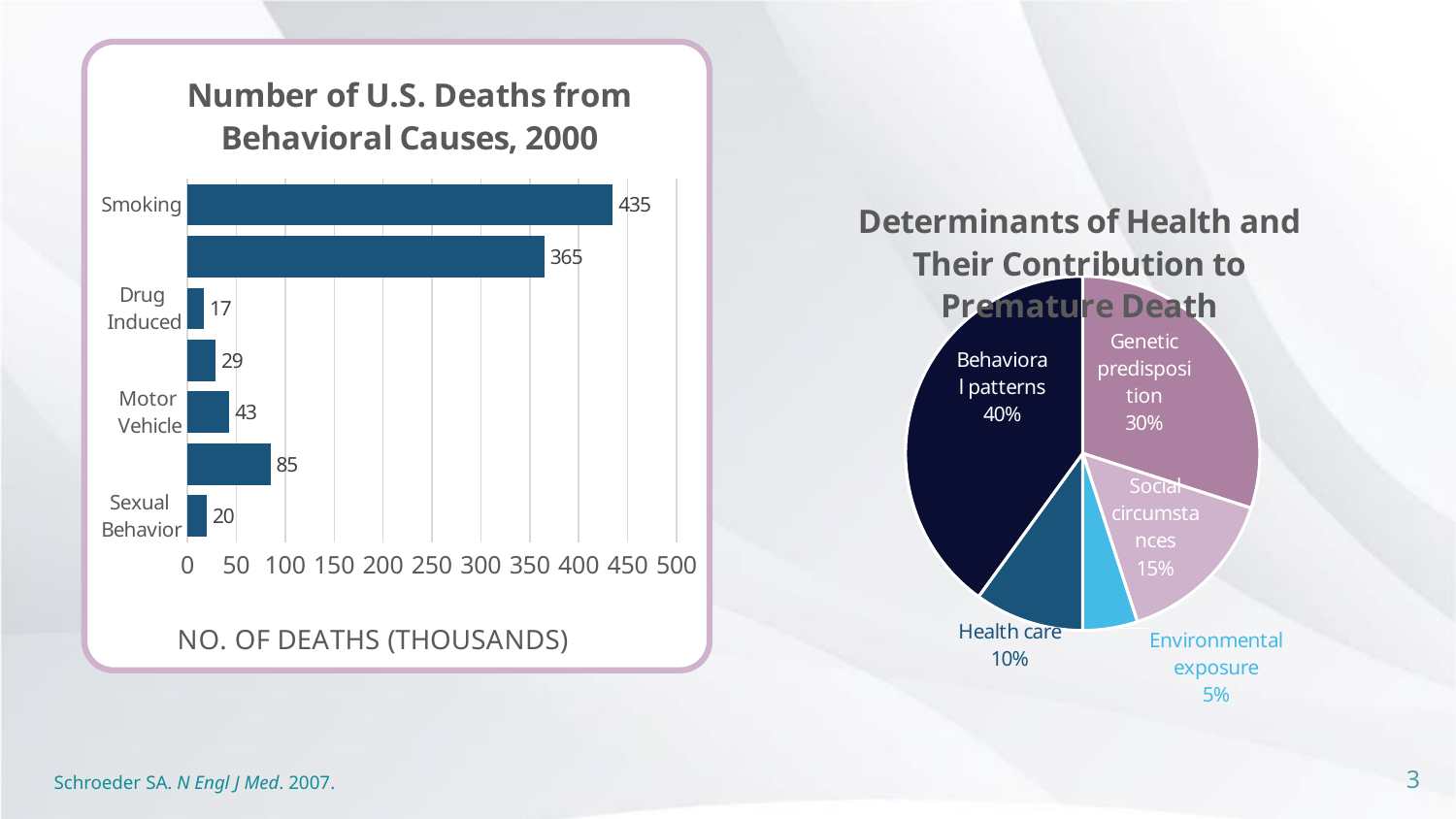
In the bar chart 'Number of U.S. Deaths from Behavioral Causes, 2000', what is the difference between the values for Smoking and Drug Induced? 418 In the bar chart 'Number of U.S. Deaths from Behavioral Causes, 2000', how many bars are plotted? 7 In the pie chart 'Determinants of Health and Their Contribution to Premature Death', how many slices are there? 5 What is the x-axis title of the bar chart on the left? NO. OF DEATHS (THOUSANDS) In the bar chart 'Number of U.S. Deaths from Behavioral Causes, 2000', which is larger, Motor Vehicle or Sexual Behavior? Motor Vehicle In the pie chart 'Determinants of Health and Their Contribution to Premature Death', what share is Genetic predisposition? 30% In the pie chart 'Determinants of Health and Their Contribution to Premature Death', which slice is the smallest? Environmental exposure In the bar chart 'Number of U.S. Deaths from Behavioral Causes, 2000', what is the value for Motor Vehicle? 43 What kind of chart is 'Number of U.S. Deaths from Behavioral Causes, 2000'? Bar chart In the bar chart 'Number of U.S. Deaths from Behavioral Causes, 2000', which labeled category has the highest value? Smoking In the bar chart 'Number of U.S. Deaths from Behavioral Causes, 2000', what is the value for Sexual Behavior? 20 In the bar chart 'Number of U.S. Deaths from Behavioral Causes, 2000', what is the value for Smoking? 435